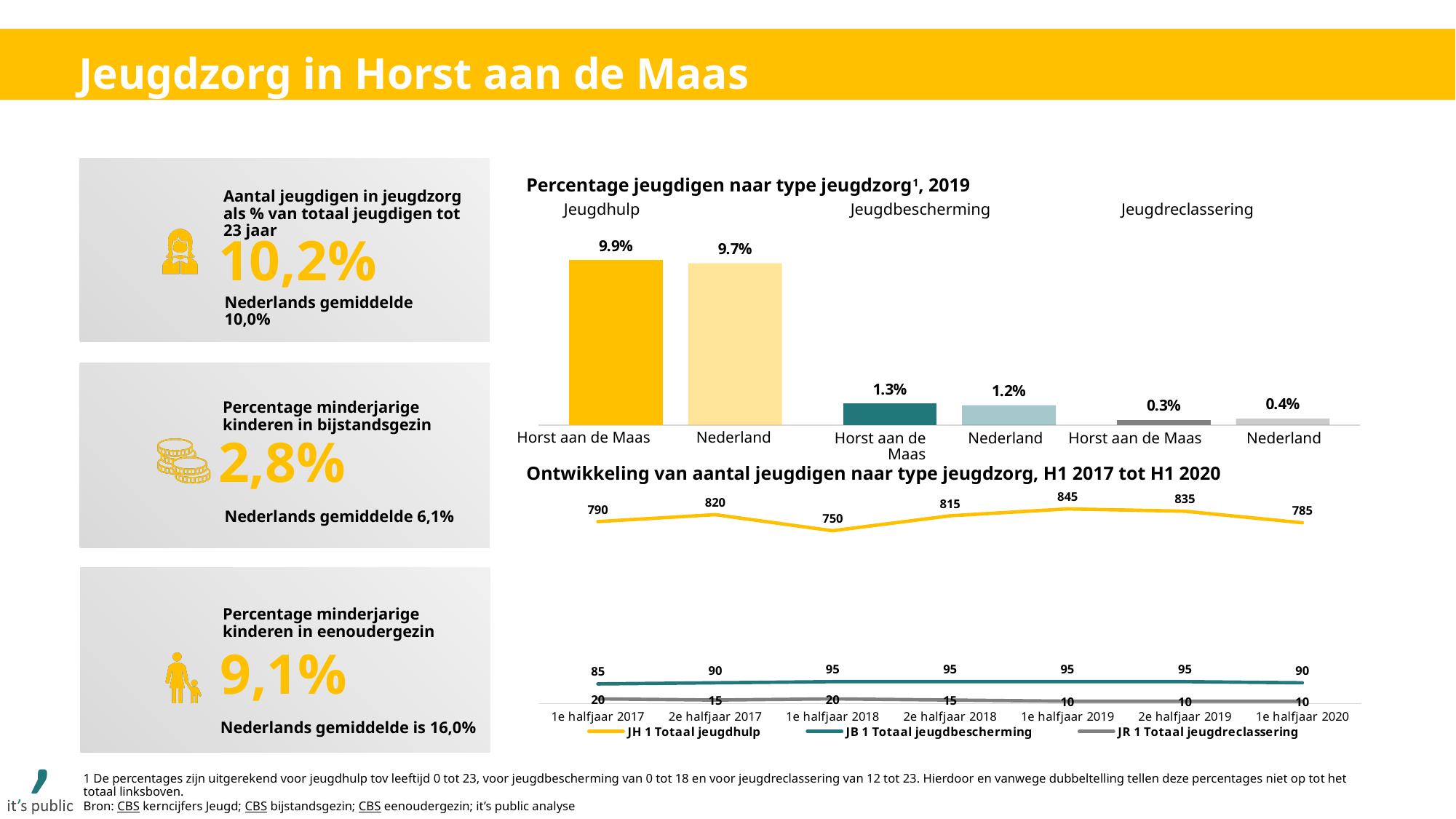
In the line chart 'Ontwikkeling van aantal jeugdigen naar type jeugdzorg, H1 2017 tot H1 2020', how many time periods are shown on the x axis? 7 What kind of chart is 'Ontwikkeling van aantal jeugdigen naar type jeugdzorg, H1 2017 tot H1 2020'? Line chart In the bar chart 'Percentage jeugdigen naar type jeugdzorg, 2019', for Jeugdreclassering, which is larger: Horst aan de Maas or Nederland? Nederland In the bar chart 'Percentage jeugdigen naar type jeugdzorg, 2019', what is the difference between the Jeugdhulp values for Horst aan de Maas and Nederland? 0.2% In the bar chart 'Percentage jeugdigen naar type jeugdzorg, 2019', which bar is the highest? Jeugdhulp, Horst aan de Maas (9.9%) In the bar chart 'Percentage jeugdigen naar type jeugdzorg, 2019', which bar is the lowest? Jeugdreclassering, Horst aan de Maas (0.3%) In the bar chart 'Percentage jeugdigen naar type jeugdzorg, 2019', what is the Jeugdbescherming value for Nederland? 1.2% In the bar chart 'Percentage jeugdigen naar type jeugdzorg, 2019', what is the Jeugdhulp value for Horst aan de Maas? 9.9% In the line chart 'Ontwikkeling van aantal jeugdigen naar type jeugdzorg, H1 2017 tot H1 2020', what is the value of JH 1 Totaal jeugdhulp in 1e halfjaar 2019? 845 In the line chart 'Ontwikkeling van aantal jeugdigen naar type jeugdzorg, H1 2017 tot H1 2020', in which period is JH 1 Totaal jeugdhulp lowest? 1e halfjaar 2018 In the line chart 'Ontwikkeling van aantal jeugdigen naar type jeugdzorg, H1 2017 tot H1 2020', how many series does the legend list? 3 In the line chart 'Ontwikkeling van aantal jeugdigen naar type jeugdzorg, H1 2017 tot H1 2020', what is the value of JR 1 Totaal jeugdreclassering in 1e halfjaar 2020? 10